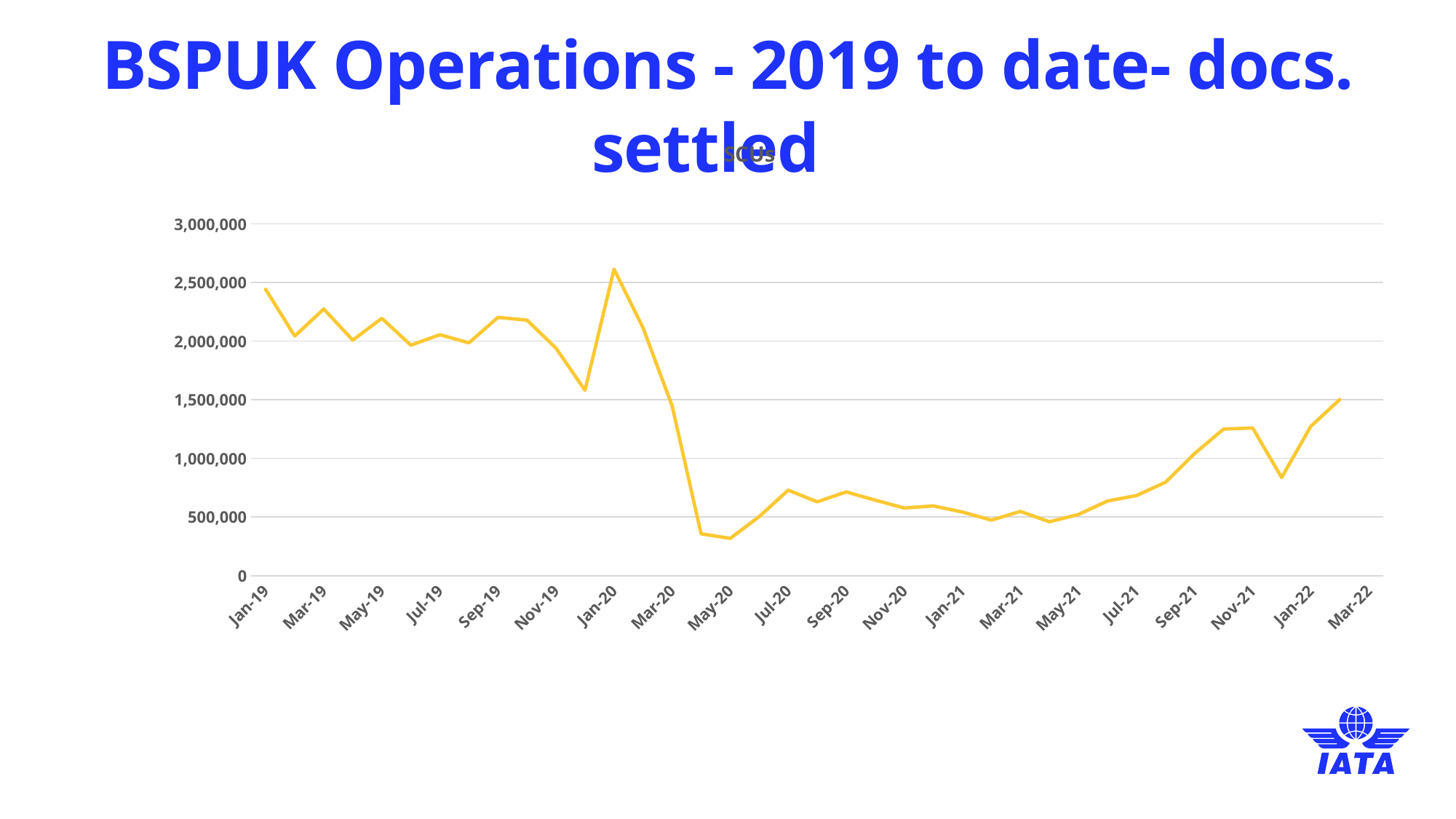
Which month has the highest value on the chart? Jan-20 Is the value for Sep-19 greater or less than 2,000,000? greater Is the value for Jul-20 greater or less than 1,000,000? less Which is larger, the value for Nov-20 or the value for Nov-21? Nov-21 What is the highest value shown on the vertical axis? 3,000,000 Which is larger, the value for Jan-19 or the value for Jan-22? Jan-19 Does the line rise or fall between Jan-20 and May-20? fall Is the value for Jan-22 greater or less than 1,000,000? greater Does the line generally rise or fall between May-21 and Mar-22? rise What kind of chart is shown on the slide? line chart